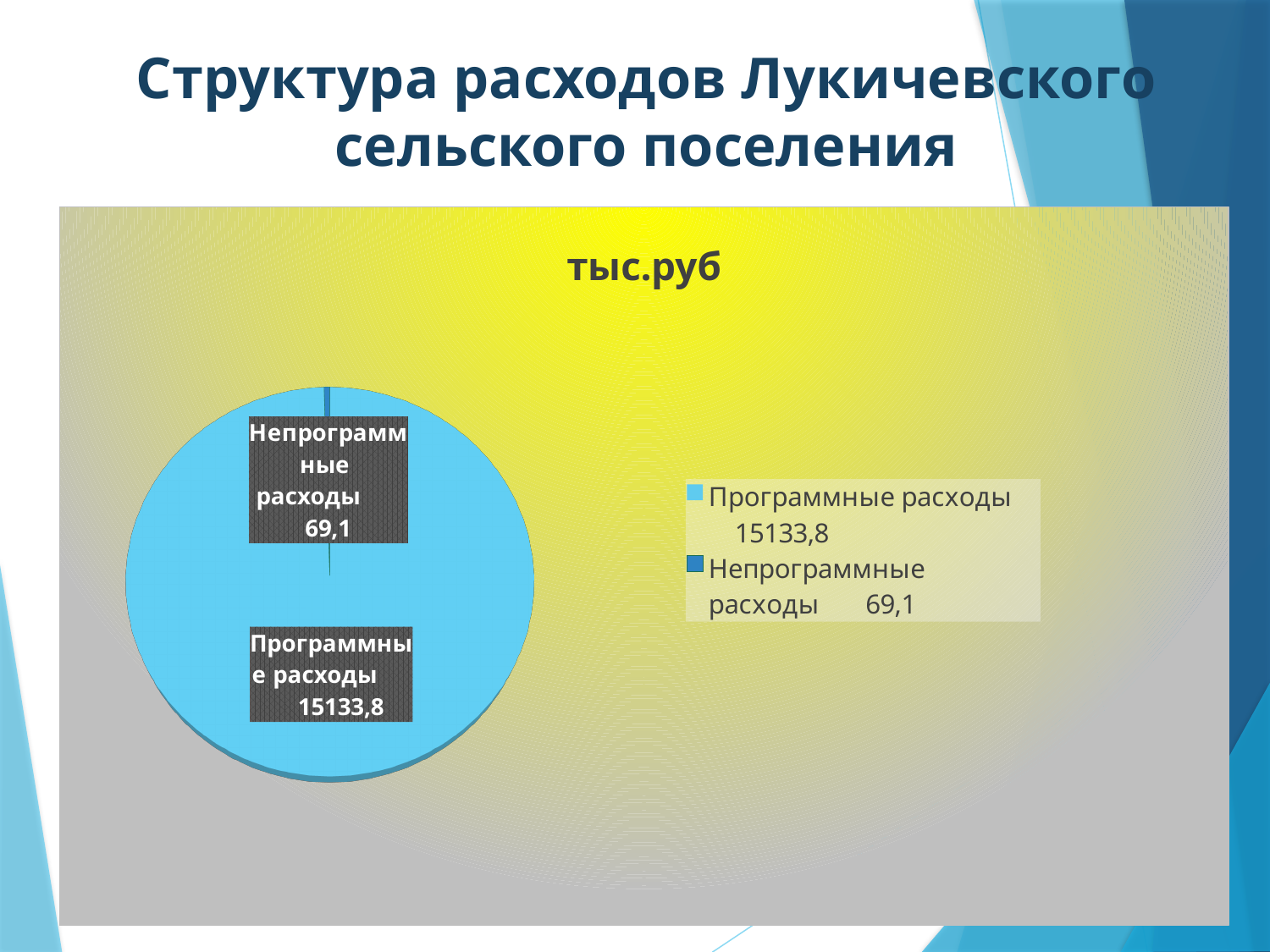
What is the total of the two slices in the pie chart? 15202,9 What colour is the slice for Программные расходы? light blue Which is larger, Программные расходы or Непрограммные расходы? Программные расходы Which category has the smallest slice of the pie? Непрограммные расходы What is the value for Непрограммные расходы? 69,1 What is the difference between Программные расходы and Непрограммные расходы? 15064,7 How many entries does the legend list? 2 How many slices does the pie chart have? 2 What is the title of the chart? тыс.руб What is the value for Программные расходы? 15133,8 What kind of chart is shown on the slide? pie chart Which category has the largest slice of the pie? Программные расходы